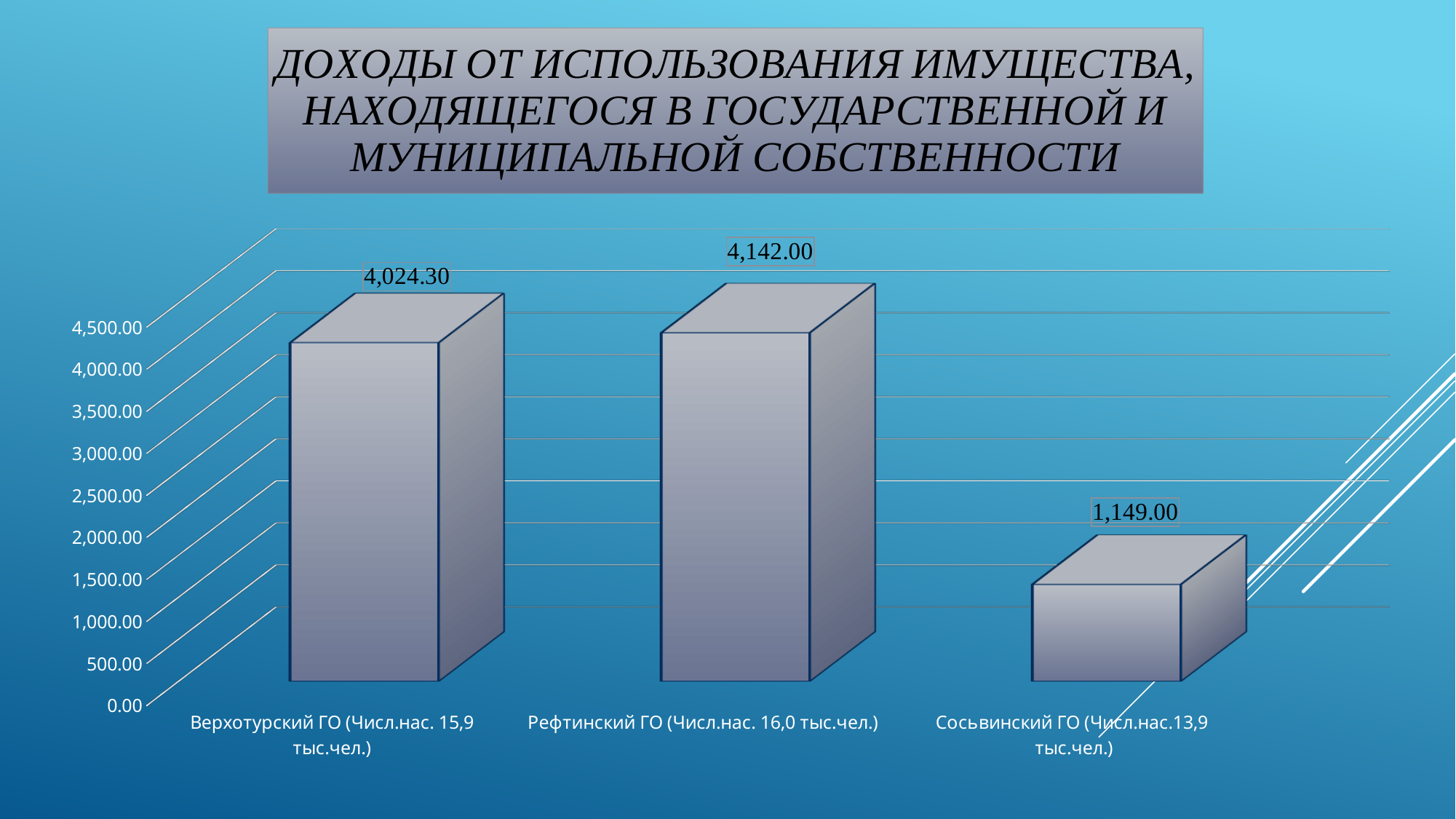
What is the difference between the values for Рефтинский ГО and Сосьвинский ГО? 2,993.00 Is the value for Сосьвинский ГО greater or less than 1,500.00? less Which category has the highest value? Рефтинский ГО How many categories are shown in the chart? 3 What is the value for Верхотурский ГО? 4,024.30 Which is larger, the value for Верхотурский ГО or the value for Сосьвинский ГО? Верхотурский ГО What kind of chart is shown on the slide? bar chart Which category has the lowest value? Сосьвинский ГО What is the value for Рефтинский ГО? 4,142.00 What is the difference between the values for Рефтинский ГО and Верхотурский ГО? 117.70 What is the population figure given in the label for Рефтинский ГО? 16,0 тыс.чел. What is the value for Сосьвинский ГО? 1,149.00